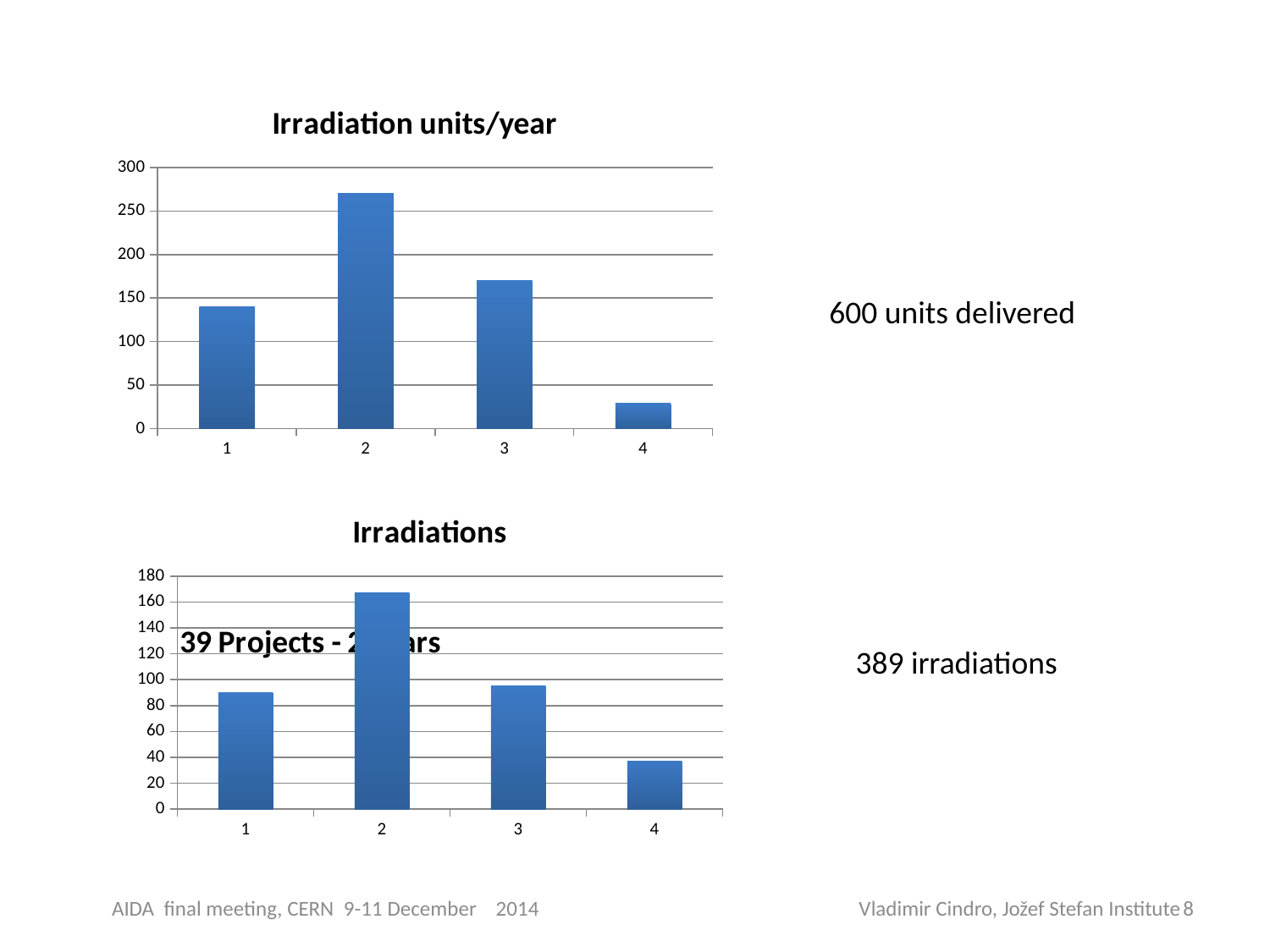
In the 'Irradiation units/year' chart, which is larger, the value for category 1 or category 3? category 3 In the 'Irradiation units/year' chart, is the value for category 4 greater or less than 50? less In the 'Irradiations' chart, is the value for category 2 greater or less than 140? greater In the 'Irradiation units/year' chart, which category has the highest value? 2 What is the title of the bottom chart on the slide? Irradiations How many categories are shown in the 'Irradiation units/year' chart? 4 In the 'Irradiation units/year' chart, is the value for category 2 greater or less than 250? greater What type of chart is the 'Irradiation units/year' chart? bar chart In the 'Irradiation units/year' chart, which category has the lowest value? 4 In the 'Irradiations' chart, which category has the lowest value? 4 In the 'Irradiations' chart, which category has the highest value? 2